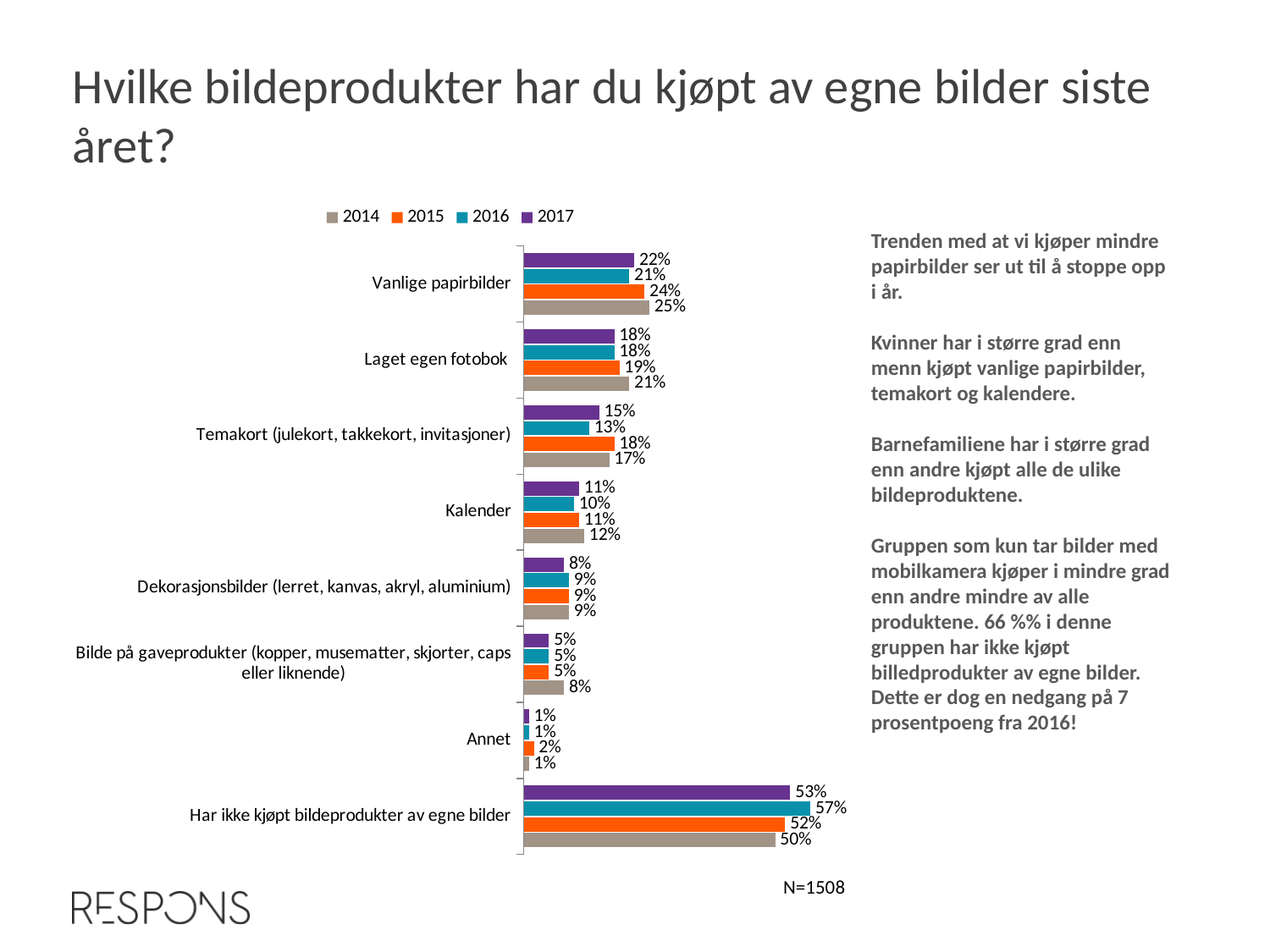
What is the 2017 value for "Vanlige papirbilder"? 22% What is the 2014 value for "Har ikke kjøpt bildeprodukter av egne bilder"? 50% How many series does the legend list? 4 What is the 2015 value for "Annet"? 2% Which colour represents the 2017 series in the chart? Purple For "Bilde på gaveprodukter (kopper, musematter, skjorter, caps eller liknende)", which year has the larger value, 2014 or 2017? 2014 Which category has the lowest 2014 value? Annet What is the 2016 value for "Temakort (julekort, takkekort, invitasjoner)"? 13% How many categories are shown on the chart? 8 Which category has the highest 2016 value? Har ikke kjøpt bildeprodukter av egne bilder What kind of chart is shown on the slide? Bar chart What is the difference between the 2016 and 2014 values for "Har ikke kjøpt bildeprodukter av egne bilder"? 7 percentage points